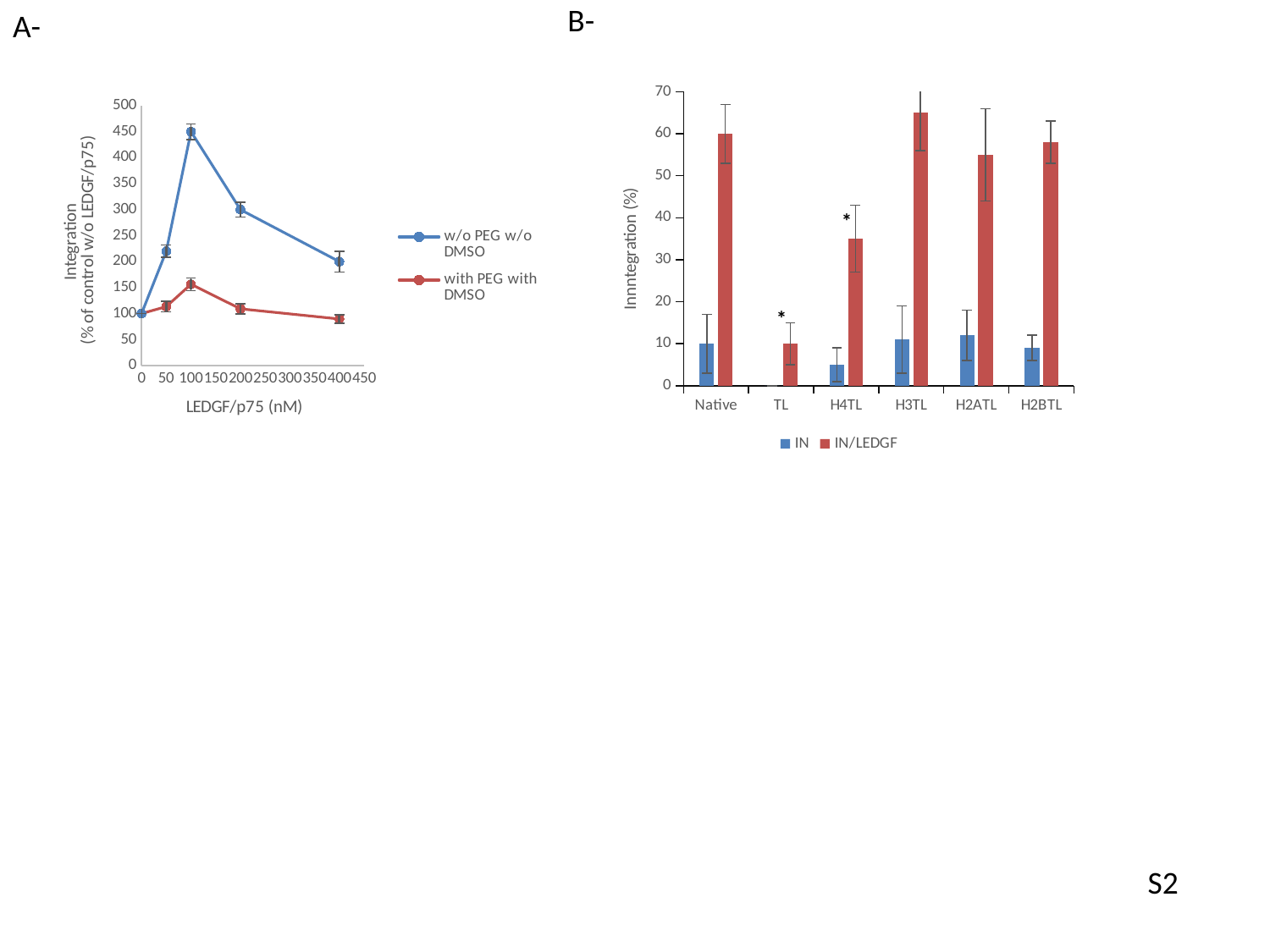
What kind of chart is chart A (the left chart)? line chart In chart B, how many series does the legend list? 2 In chart A, does the w/o PEG w/o DMSO series rise or fall between 100 nM and 400 nM? fall In chart B, which category has the lowest IN/LEDGF value? TL In chart B, how many categories are shown on the x axis? 6 In chart A, at which LEDGF/p75 concentration does the w/o PEG w/o DMSO series reach its highest value? 100 nM In chart B, is the IN/LEDGF value for H4TL greater or less than 40? less In chart A, is the w/o PEG w/o DMSO value at 100 nM greater or less than 400? greater In chart A, how many series does the legend list? 2 What kind of chart is chart B (the right chart)? bar chart In chart B, which category has the highest IN/LEDGF value? H3TL In chart B, is the IN/LEDGF value for Native greater or less than 50? greater